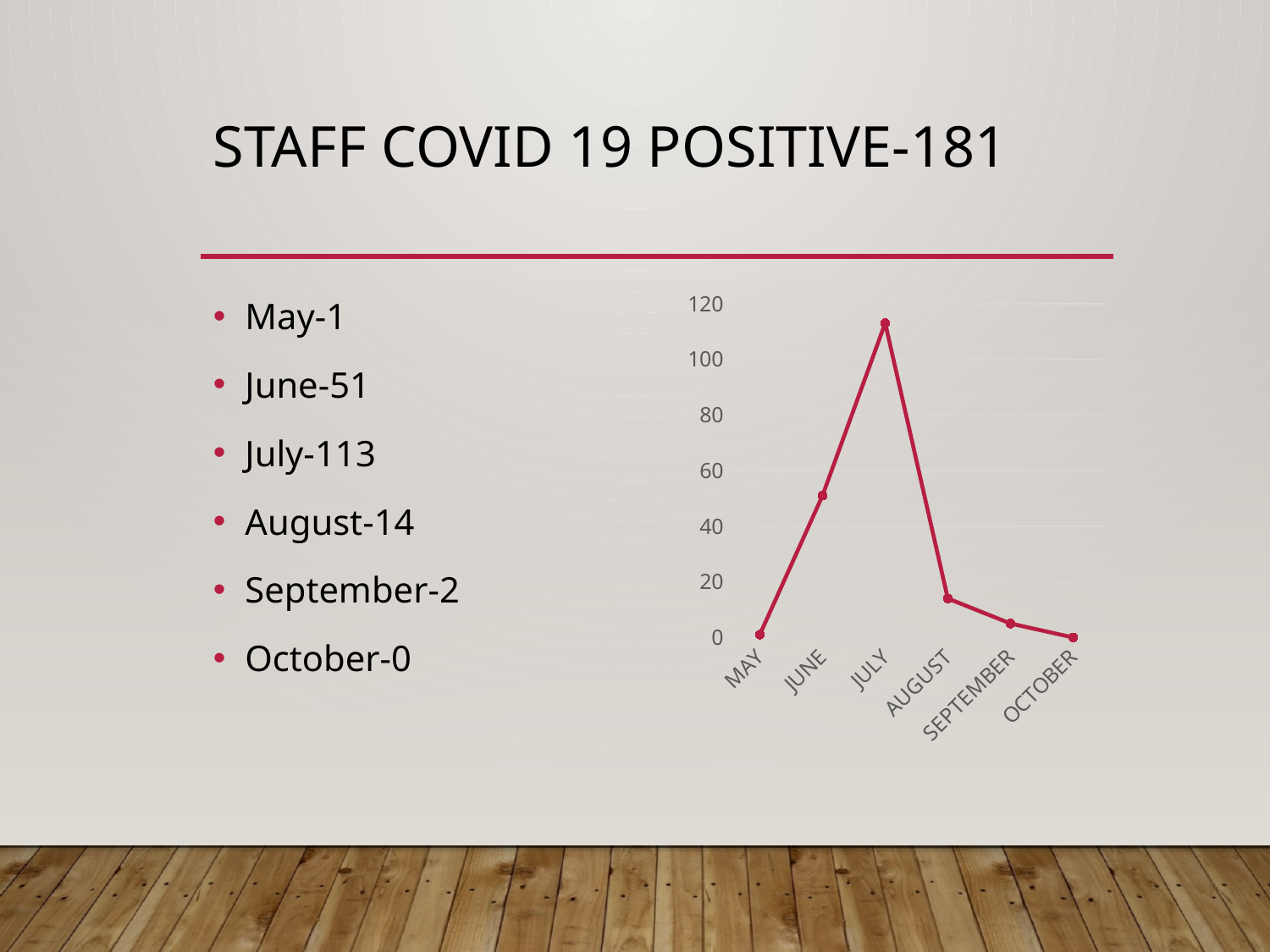
Which is larger, the value for June or the value for August? June Which month has the highest value on the chart? July How many months are plotted on the x axis of the chart? 6 Is the value for July greater or less than 100? greater What is the title of the slide containing the chart? STAFF COVID 19 POSITIVE-181 Does the line rise or fall from July to October? fall What is the difference between the July and June values? 62 What is the value for July? 113 What kind of chart is shown on the slide? line chart What is the value for August? 14 What is the value for June? 51 Which month has the lowest value on the chart? October